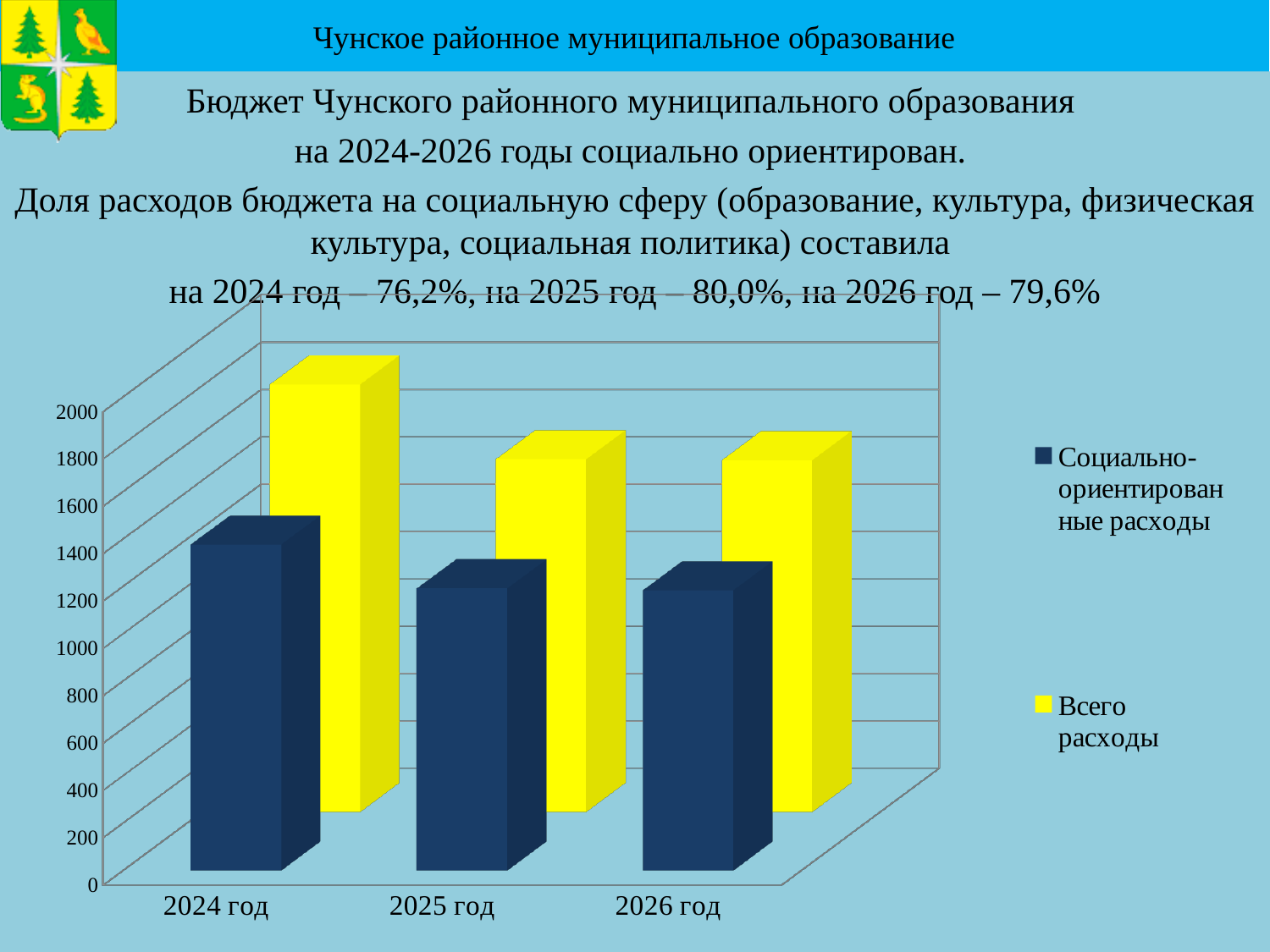
How many series does the chart legend list? 2 Which year has the highest value for Социально-ориентированные расходы? 2024 год Which year has the highest value for Всего расходы? 2024 год Do the values for Всего расходы rise or fall from 2024 год to 2025 год? fall Which colour represents Всего расходы in the chart? yellow Is the value for Социально-ориентированные расходы in 2024 год greater or less than 1000? greater What kind of chart is shown on the slide? bar chart Which is larger: Социально-ориентированные расходы in 2024 год or in 2025 год? 2024 год Is the value for Социально-ориентированные расходы in 2025 год greater or less than 1600? less How many years (categories) are shown on the x axis of the chart? 3 Is the value for Всего расходы in 2026 год greater or less than 1400? greater